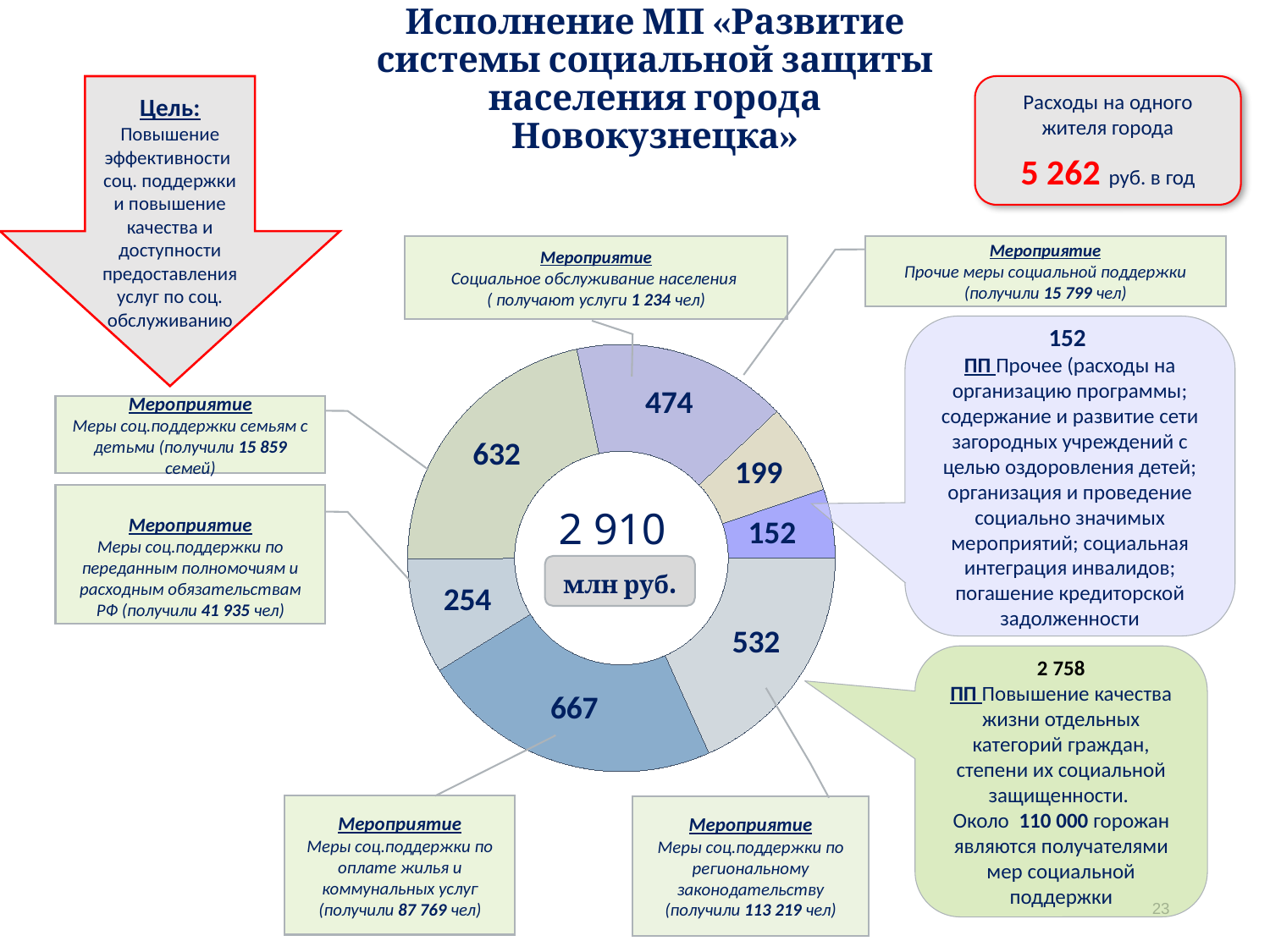
What is the value of the segment for «Меры соц.поддержки семьям с детьми»? 632 Which segment of the donut chart has the largest value? 667 (Меры соц.поддержки по оплате жилья и коммунальных услуг) What unit is shown in the centre of the donut chart? млн руб. What is the difference between the segment values 667 and 632? 35 How many segments does the donut chart have? 7 What is the value of the segment for «Прочие меры социальной поддержки»? 199 What total value is shown in the centre of the donut chart? 2 910 млн руб. What kind of chart is shown on the slide? Pie (donut) chart What is the value of the segment for «Социальное обслуживание населения»? 474 What is the value of the segment for «Меры соц.поддержки по региональному законодательству»? 532 Which is larger: the segment for «Меры соц.поддержки по переданным полномочиям и расходным обязательствам РФ» or the segment for «Прочие меры социальной поддержки»? Меры соц.поддержки по переданным полномочиям и расходным обязательствам РФ (254) Which segment of the donut chart has the smallest value? 152 (ПП Прочее)